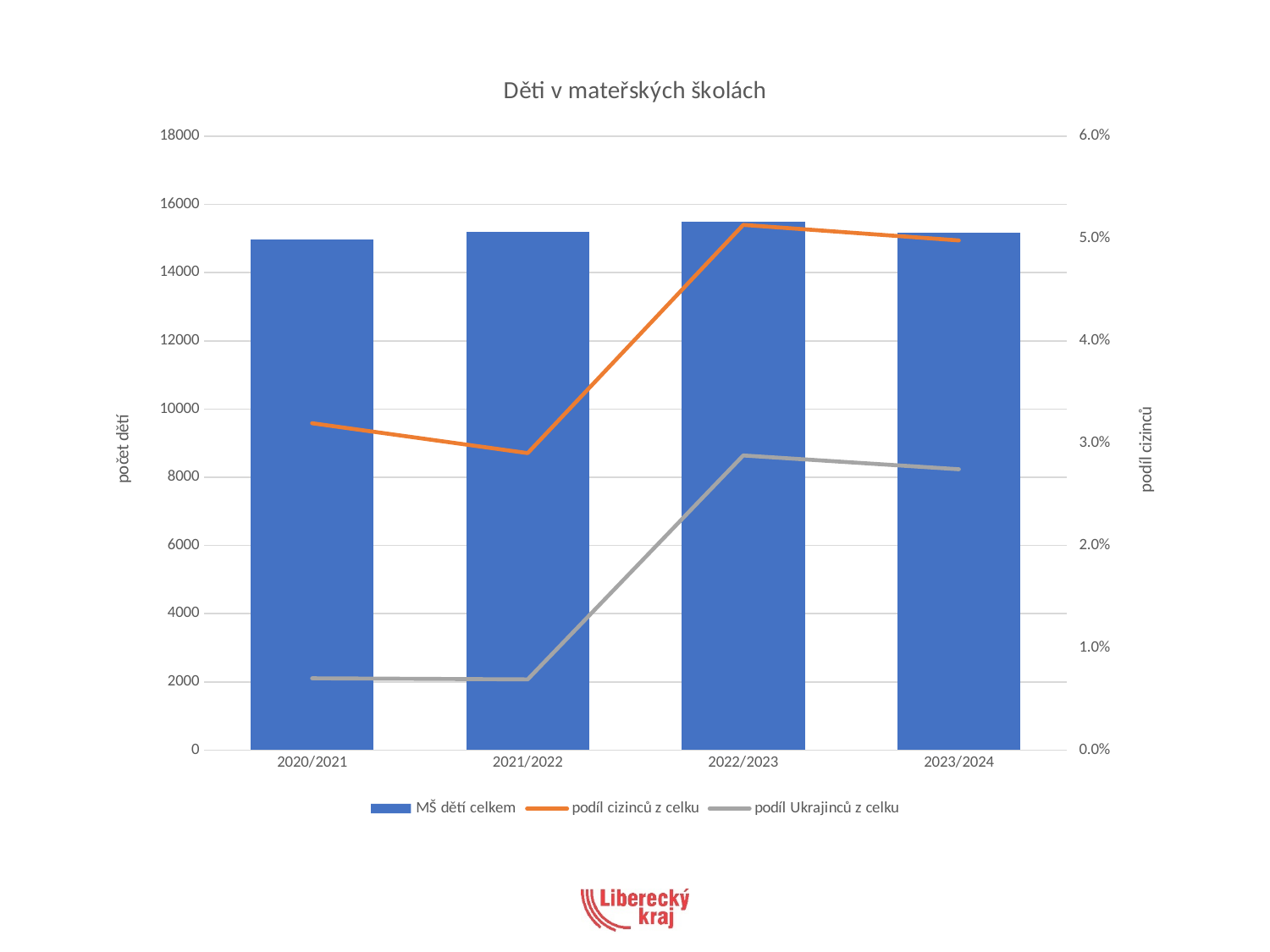
In which school year is the podíl cizinců z celku line at its lowest? 2021/2022 What is the title of the chart? Děti v mateřských školách What kind of chart is shown on the slide? A combined bar and line chart In which school year does the podíl cizinců z celku line reach its highest value? 2022/2023 Is the value of podíl Ukrajinců z celku for 2020/2021 greater or less than 1.0%? less In which school year is the bar for MŠ dětí celkem the highest? 2022/2023 Is the value of podíl Ukrajinců z celku for 2022/2023 greater or less than 2.0%? greater Is the value of MŠ dětí celkem for 2020/2021 greater or less than 16000? less How many school years are shown on the x axis? 4 How many series does the legend list? 3 In 2020/2021, which is larger: podíl cizinců z celku or podíl Ukrajinců z celku? podíl cizinců z celku